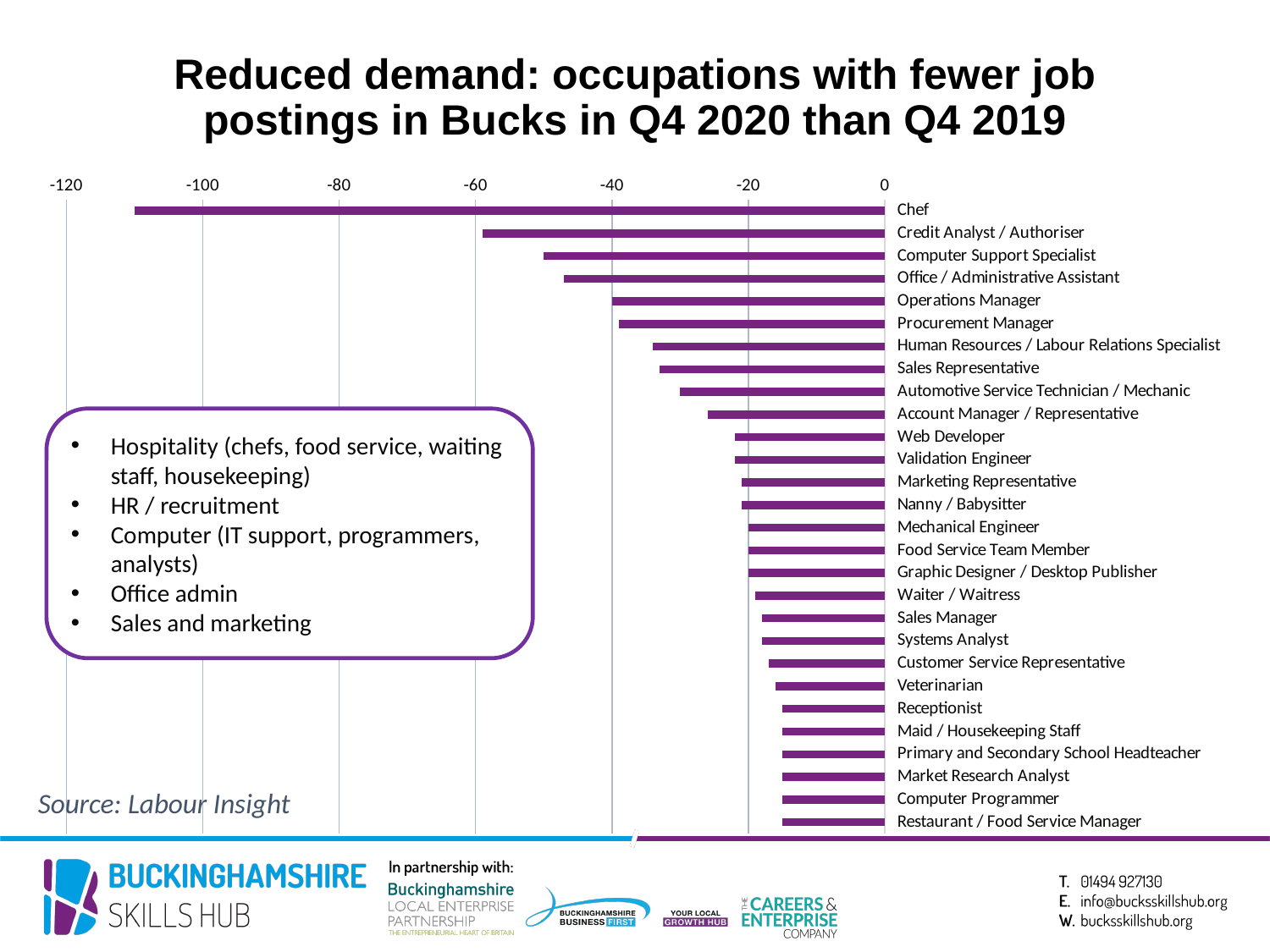
Which has the larger reduction in job postings, Chef or Credit Analyst / Authoriser? Chef Which has the larger reduction in job postings, Computer Support Specialist or Sales Representative? Computer Support Specialist Is the value for Computer Support Specialist greater or less than -40? less How many occupations are listed on the chart? 28 What kind of chart is shown on the slide? Bar chart Which occupation has the largest reduction in job postings (the longest bar)? Chef Is the value for Human Resources / Labour Relations Specialist greater or less than -40? greater Is the value for Account Manager / Representative greater or less than -20? less What is the title of the chart? Reduced demand: occupations with fewer job postings in Bucks in Q4 2020 than Q4 2019 Going down the chart from Chef to Restaurant / Food Service Manager, do the bars get longer or shorter? Shorter